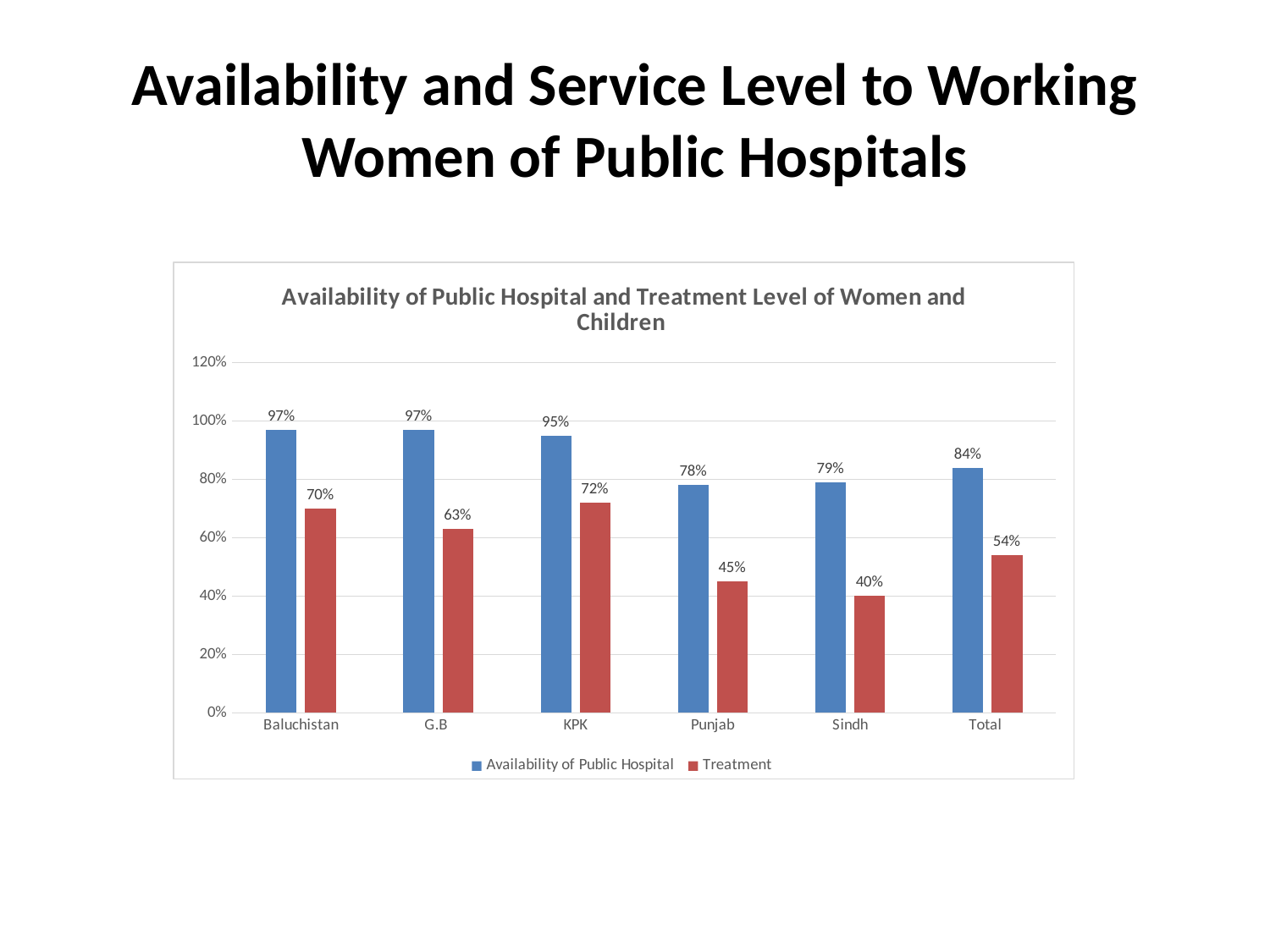
What kind of chart is shown on the slide? Bar chart What is the Availability of Public Hospital value for Total? 84% What is the difference between the Availability of Public Hospital and Treatment values for Punjab? 33% How many series does the legend list? 2 Which category has the lowest Treatment value? Sindh What is the Availability of Public Hospital value for Baluchistan? 97% What is the Treatment value for Sindh? 40% Which is larger, the Treatment value for G.B or the Treatment value for Punjab? G.B Which category has the lowest Availability of Public Hospital value? Punjab How many categories are shown on the x axis? 6 Which category has the highest Treatment value? KPK What is the Treatment value for KPK? 72%